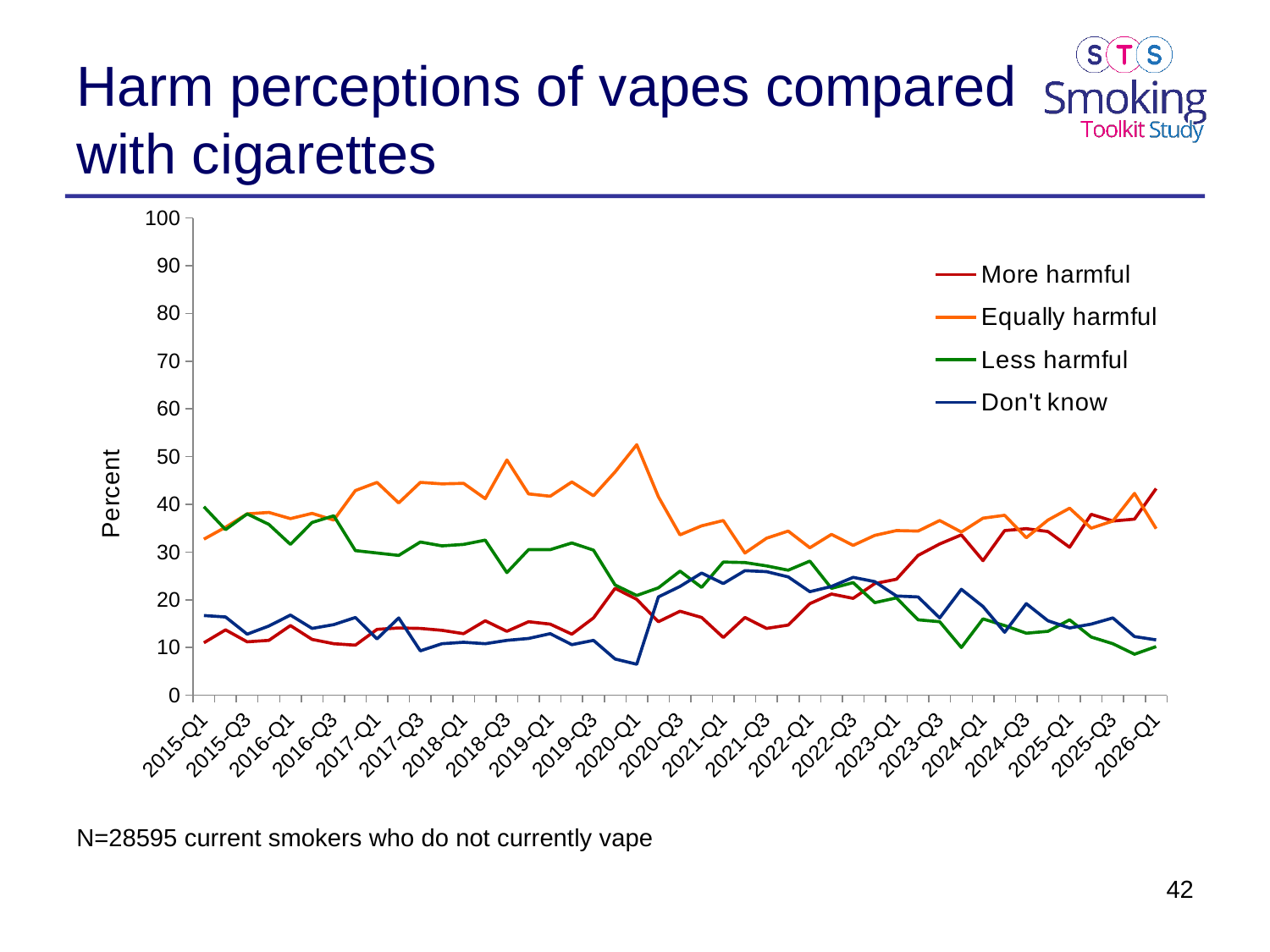
Is the value for Less harmful at 2026-Q1 greater or less than 20? less What is the label on the vertical axis? Percent At 2026-Q1, which is larger: More harmful or Less harmful? More harmful Which series is highest at 2020-Q1? Equally harmful Is the value for More harmful at 2015-Q1 greater or less than 20? less What kind of chart is shown on the slide? Line chart Does the Less harmful series generally rise or fall from 2015-Q1 to 2026-Q1? Fall Which series is highest at 2018-Q3? Equally harmful Is the value for Equally harmful at 2020-Q1 greater or less than 40? greater Which series is lowest at 2020-Q1? Don't know How many series does the legend list? 4 What is the title of the slide's chart? Harm perceptions of vapes compared with cigarettes